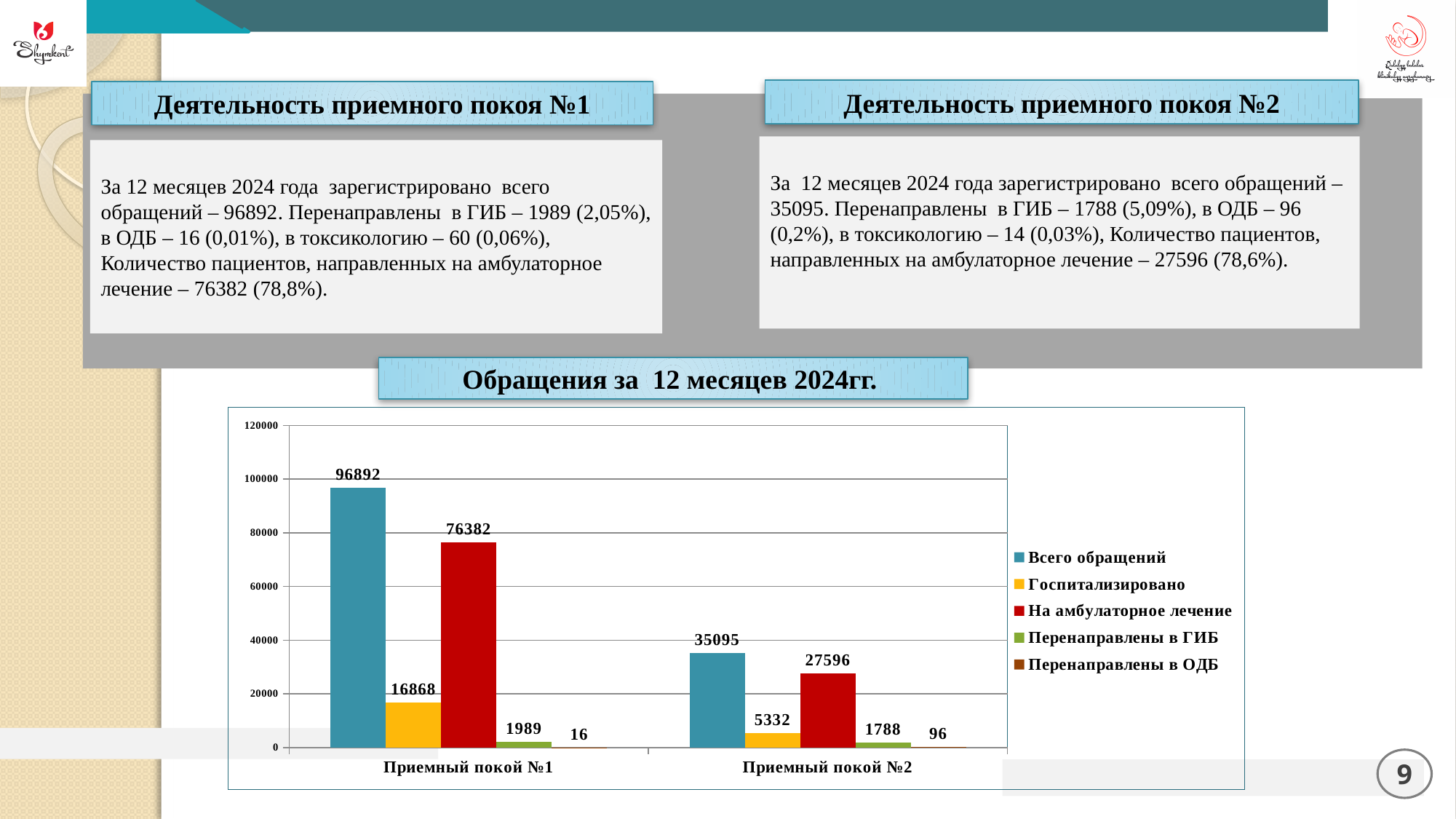
What type of chart is shown on the slide? bar chart Which category has the higher value for 'Всего обращений'? Приемный покой №1 What is the value of 'Перенаправлены в ОДБ' for Приемный покой №2? 96 What is the value of 'Госпитализировано' for Приемный покой №2? 5332 What is the difference between 'Всего обращений' for Приемный покой №1 and Приемный покой №2? 61797 Which is larger: 'Перенаправлены в ГИБ' for Приемный покой №1 or for Приемный покой №2? Приемный покой №1 How many series does the legend list? 5 What is the value of 'Всего обращений' for Приемный покой №1? 96892 Which series has the lowest value for Приемный покой №1? Перенаправлены в ОДБ Is the value of 'На амбулаторное лечение' for Приемный покой №2 greater or less than 40000? less What is the value of 'На амбулаторное лечение' for Приемный покой №1? 76382 How many categories are shown on the x axis? 2